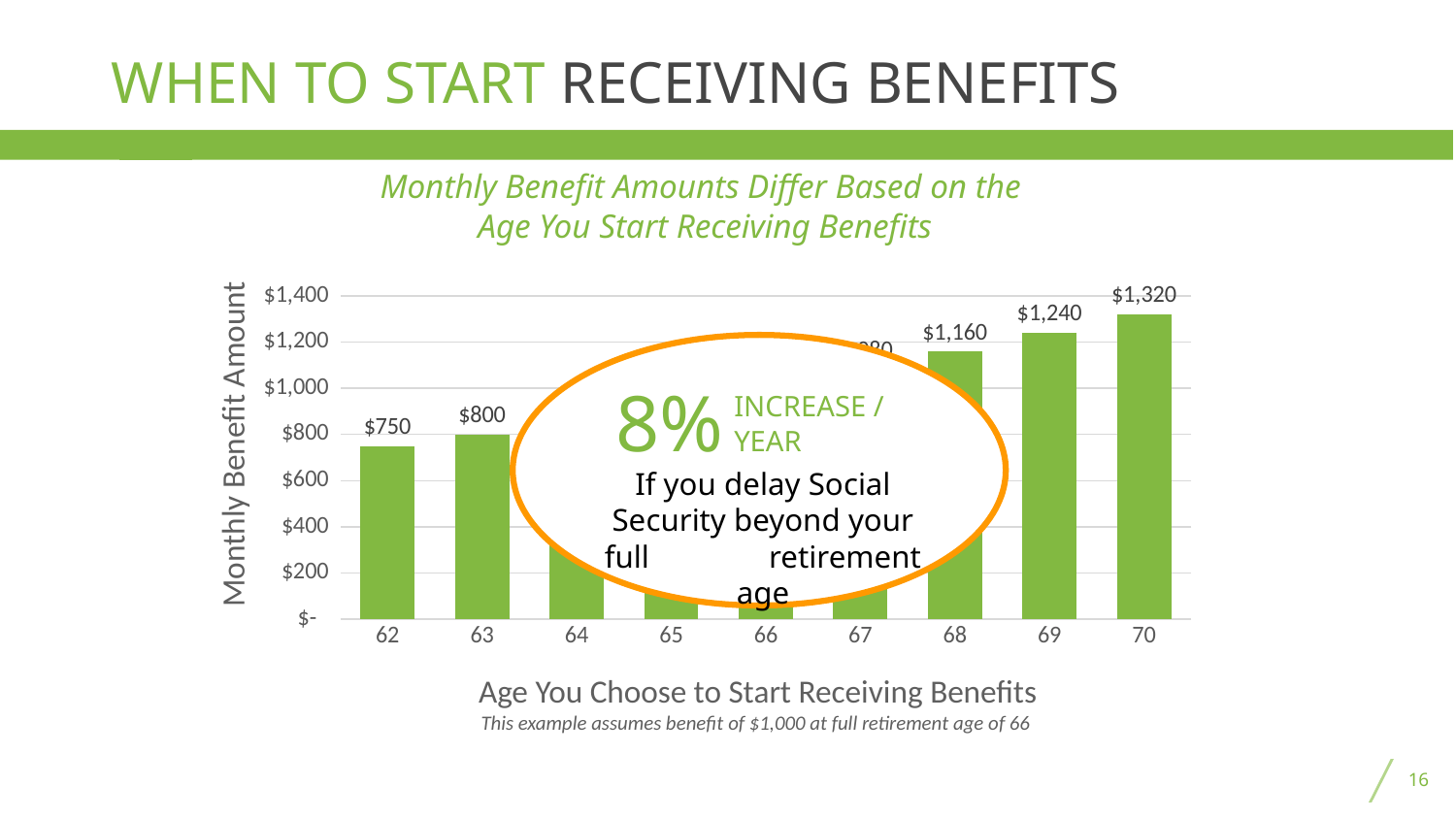
What kind of chart is shown on the slide? Bar chart What is the monthly benefit amount for age 62? $750 What is the difference between the monthly benefit at age 69 and at age 68? $80 What is the monthly benefit amount for age 68? $1,160 Which is larger, the monthly benefit at age 63 or at age 69? Age 69 Which starting age has the highest monthly benefit amount? 70 Do the monthly benefit amounts rise or fall as the starting age increases? Rise What is the monthly benefit amount for age 63? $800 What is the difference between the monthly benefit at age 70 and at age 62? $570 How many starting ages are shown on the x axis of the chart? 9 What is the monthly benefit amount for age 70? $1,320 Which starting age has the lowest monthly benefit amount? 62